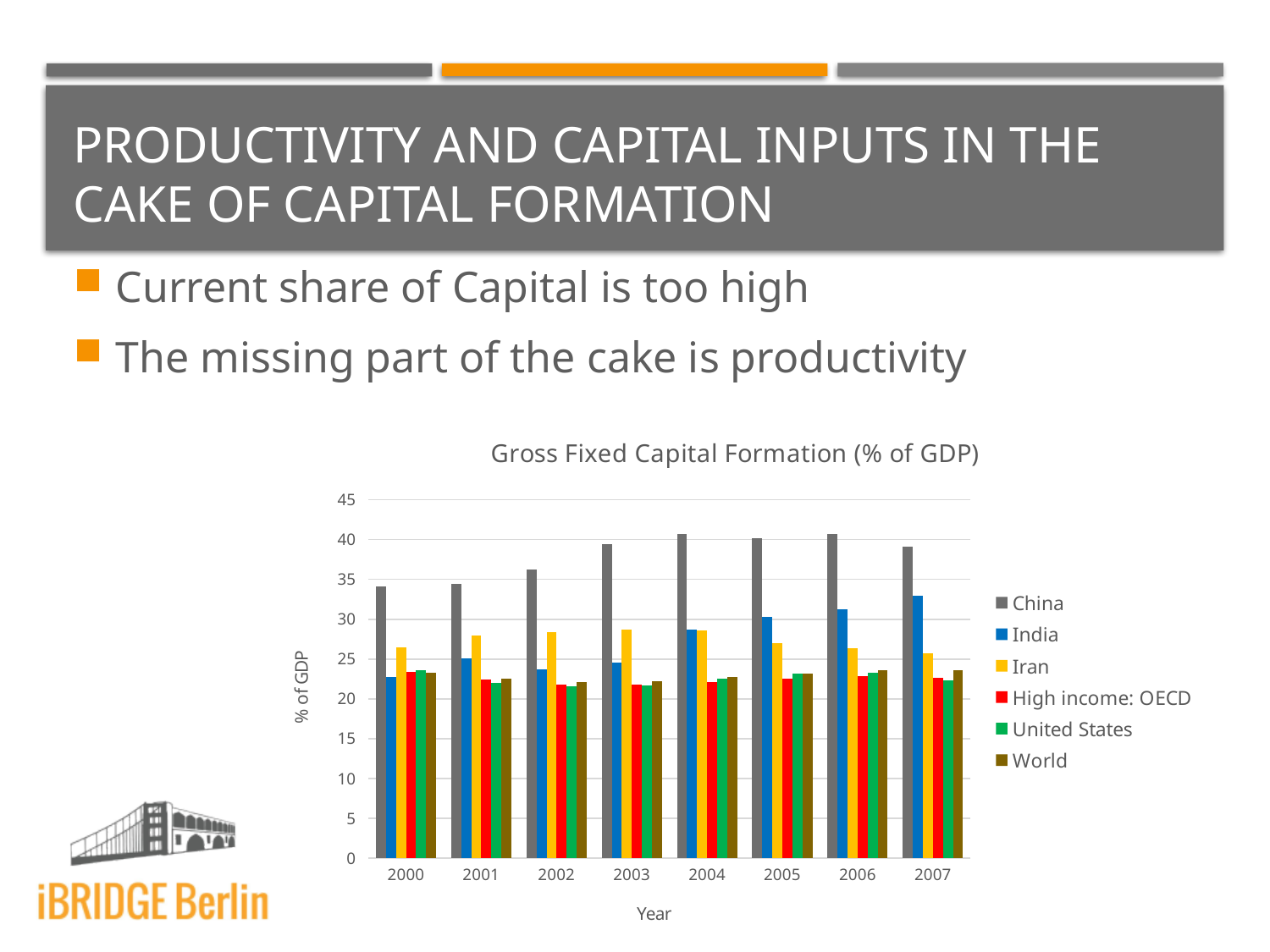
Is the value for China in 2000 greater or less than 30? greater How many years are shown on the x axis of the chart? 8 Which series has the highest value in 2004? China What is the title of the chart? Gross Fixed Capital Formation (% of GDP) Is the value for India in 2007 greater or less than 30? greater Which is larger in 2007, the value for India or the value for Iran? India Which is larger in 2000, the value for India or the value for Iran? Iran Does the value for India generally rise or fall from 2000 to 2007? rise What kind of chart is shown on the slide? bar chart In which year does India reach its highest value? 2007 How many series does the legend of the chart list? 6 Is the value for India in 2000 greater or less than 25? less